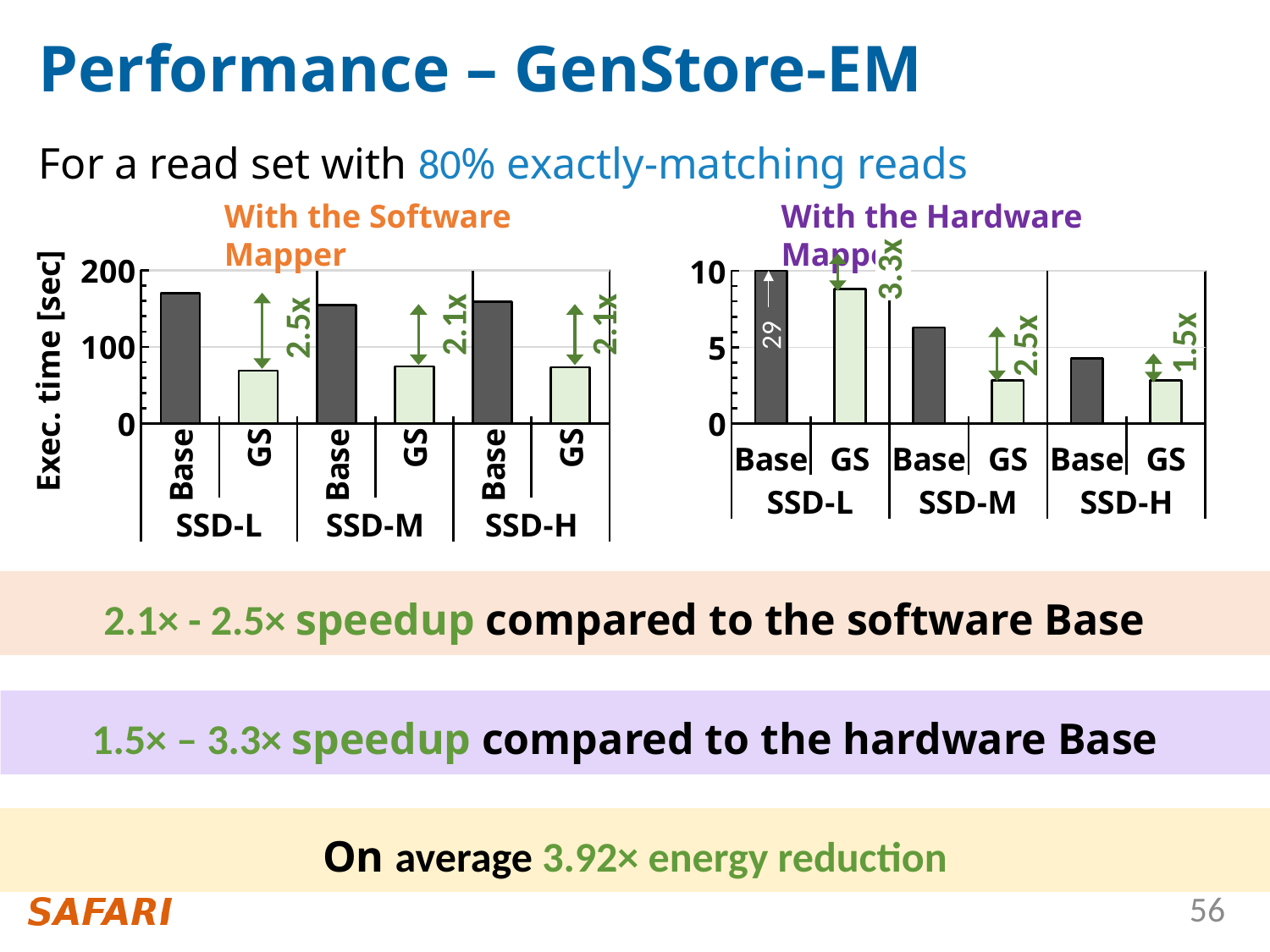
In the chart titled "With the Hardware Mapper", what speedup is annotated for SSD-H? 1.5x In the chart titled "With the Software Mapper", what speedup is annotated for SSD-M? 2.1x What type of chart is the chart titled "With the Hardware Mapper"? bar chart In the chart titled "With the Hardware Mapper", is the GS execution time for SSD-H greater or less than 5? less In the chart titled "With the Hardware Mapper", which SSD configuration has the highest annotated speedup? SSD-L In the chart titled "With the Software Mapper", is the GS execution time for SSD-M greater or less than 100? less In the chart titled "With the Software Mapper", is the Base execution time for SSD-L greater or less than 100? greater In the chart titled "With the Hardware Mapper", which SSD configuration has the lowest annotated speedup? SSD-H In the chart titled "With the Software Mapper", what speedup is annotated for SSD-L? 2.5x In the chart titled "With the Software Mapper", which bar is taller for SSD-H, Base or GS? Base In the chart titled "With the Hardware Mapper", what value is printed on the Base bar for SSD-L? 29 In the chart titled "With the Hardware Mapper", what speedup is annotated for SSD-L? 3.3x